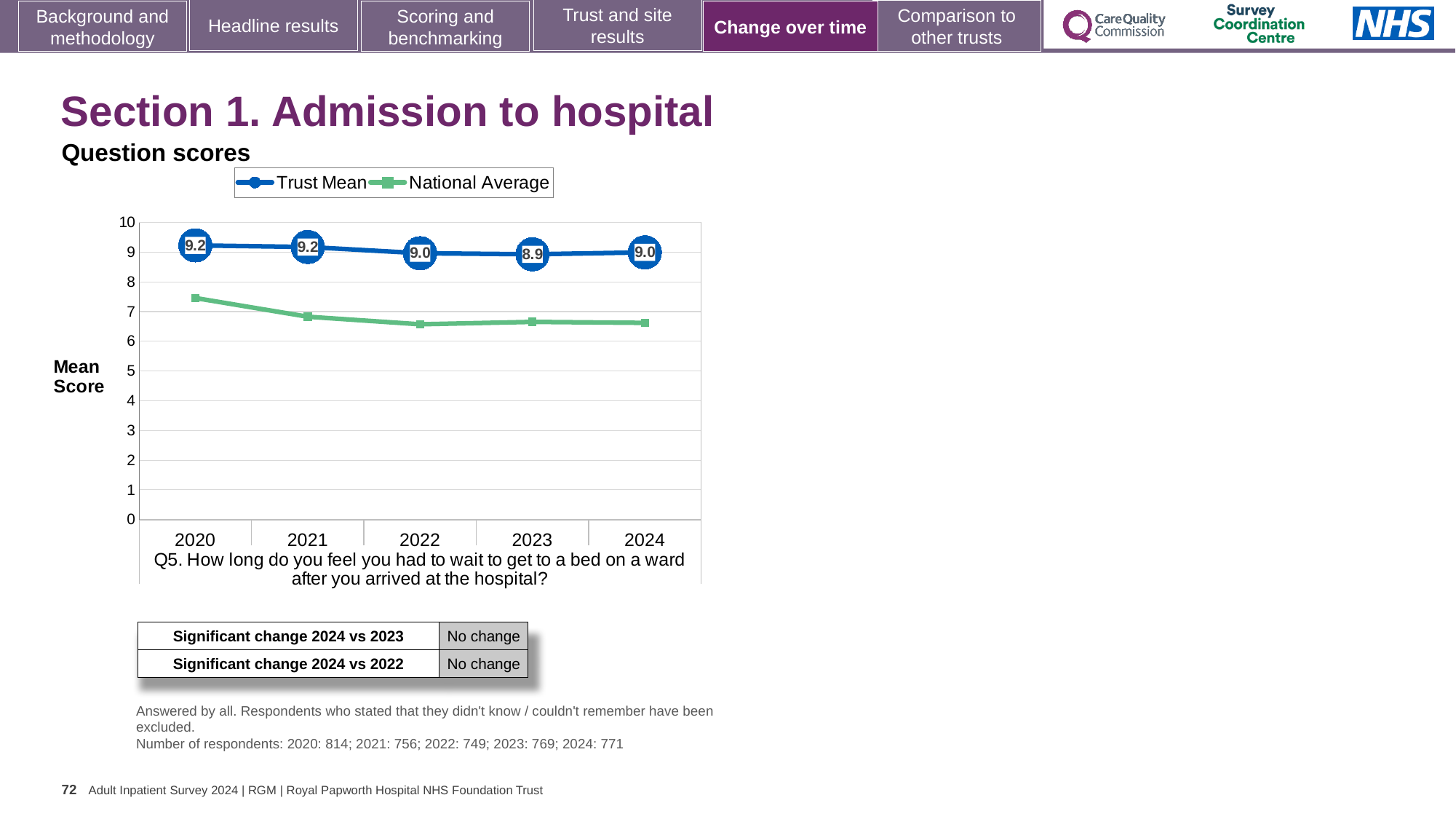
Is the National Average for 2022 greater or less than 7? less What is the Trust Mean score for 2023? 8.9 Does the Trust Mean generally rise or fall from 2020 to 2023? fall What is the difference between the Trust Mean in 2020 and in 2024? 0.2 What is the Trust Mean score for 2024? 9.0 Is the Trust Mean for 2022 larger or smaller than the Trust Mean for 2020? smaller Is the National Average for 2020 greater or less than 7? greater In which year is the Trust Mean lowest? 2023 How many series does the legend list? 2 How many years are plotted on the x axis? 5 What kind of chart is shown? line chart What is the Trust Mean score for 2020? 9.2